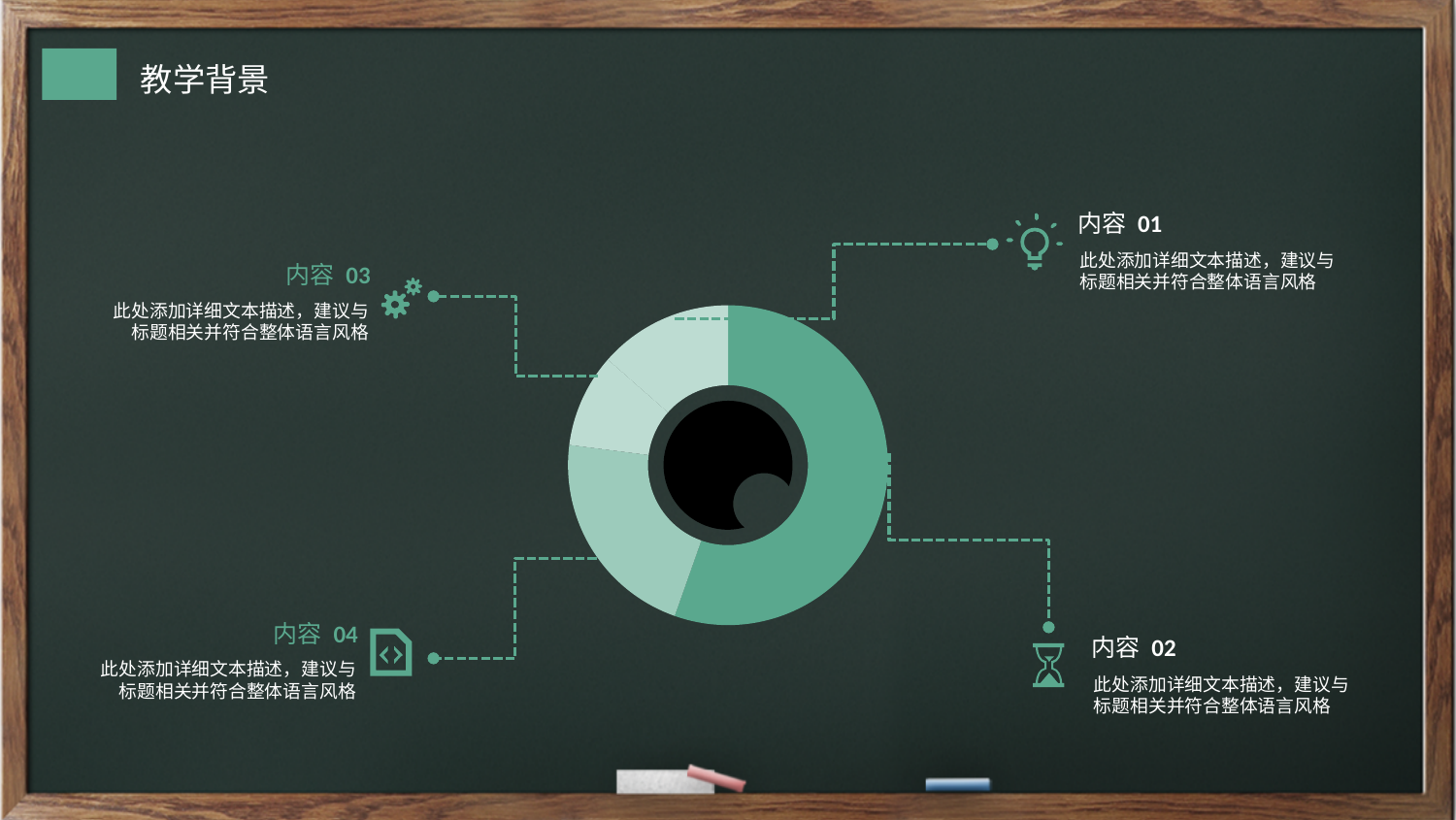
Does the doughnut chart show any data labels or percentage values on its slices? No Which slice of the doughnut chart is the largest? The dark green slice on the right Does the dark green slice take up more or less than half of the doughnut chart? More What kind of chart is shown in the centre of the slide? Doughnut (pie) chart How many content labels (内容 01 to 内容 04) are connected to the doughnut chart by dotted lines? 4 What is the title of the slide containing the doughnut chart? 教学背景 How many slices does the doughnut chart have? 4 Is the dark green slice larger or smaller than the medium green slice at the bottom left? Larger